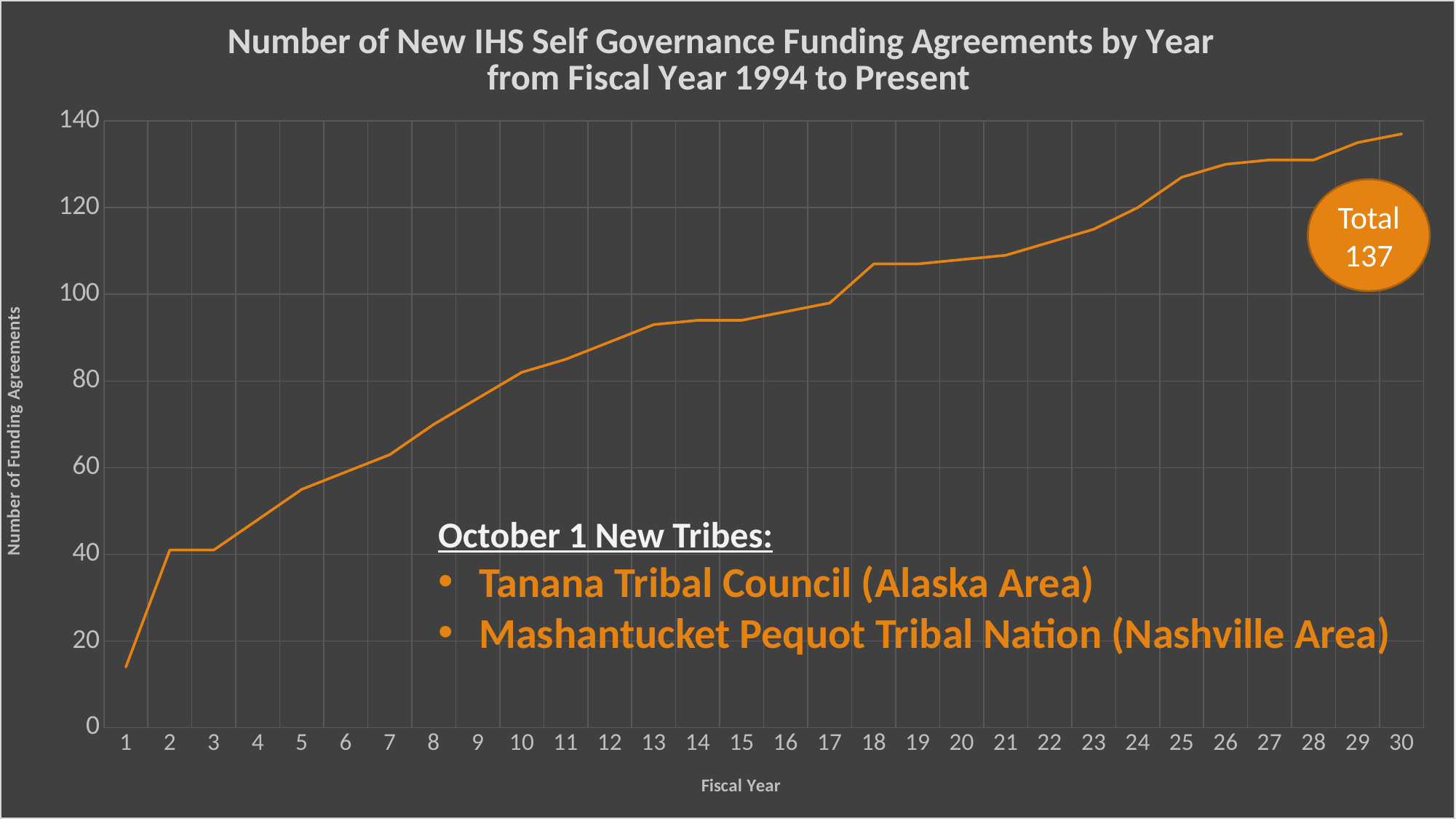
How many fiscal years are plotted along the x axis? 30 Which fiscal year has the lowest number of funding agreements? 1 Is the value for fiscal year 13 greater or less than 80? greater What total is shown in the orange circle on the chart? 137 Is the value for fiscal year 18 greater or less than 100? greater Is the value for fiscal year 15 greater or less than 100? less What kind of chart is shown on the slide? line chart Which is larger, the value for fiscal year 10 or the value for fiscal year 20? fiscal year 20 Which fiscal year has the highest number of funding agreements? 30 Do the values rise or fall as the fiscal year increases along the x axis? rise